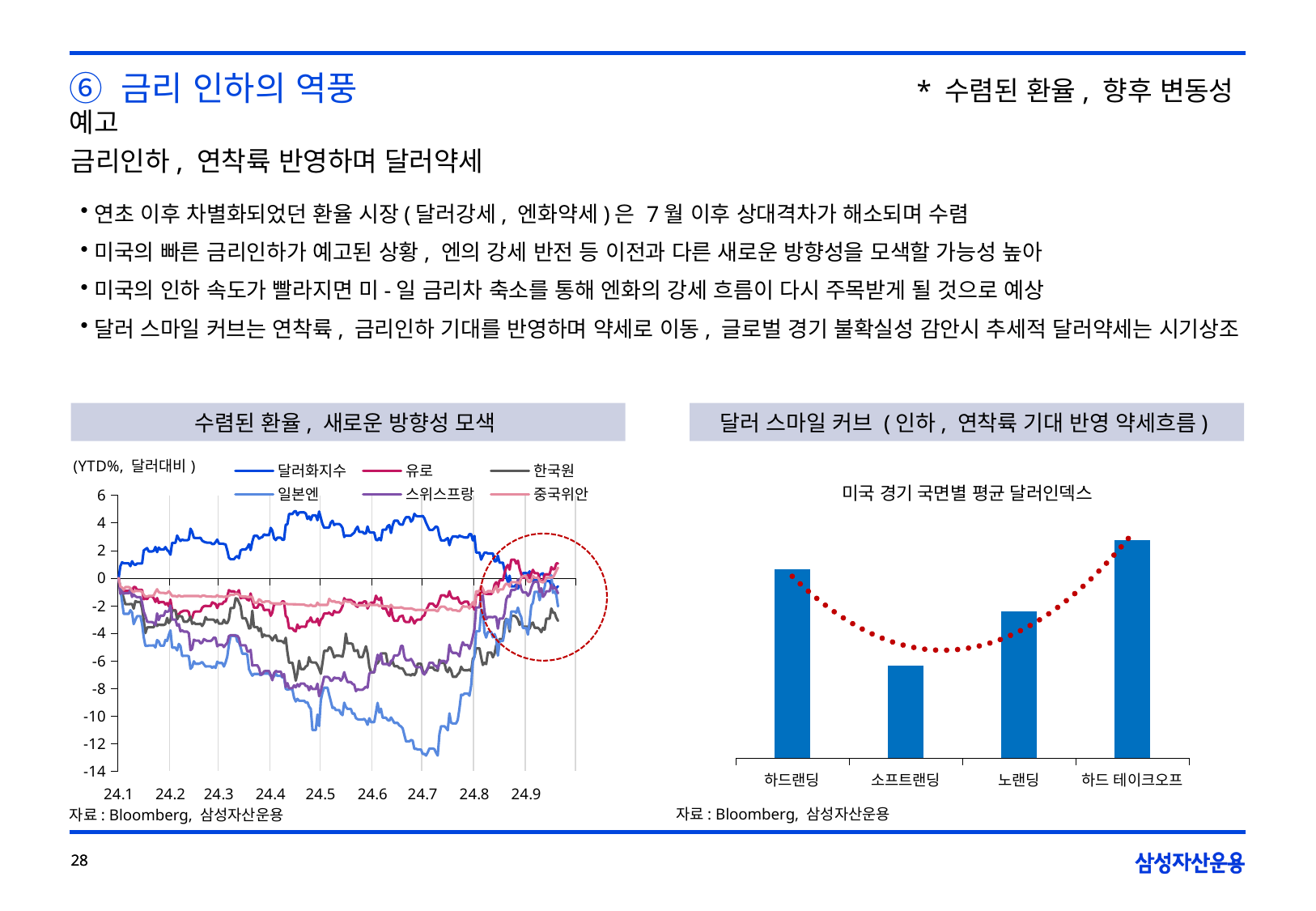
In the right chart '미국 경기 국면별 평균 달러인덱스', which category has the lowest bar? 소프트랜딩 In the left chart '수렴된 환율, 새로운 방향성 모색', is the peak of the 달러화지수 line greater or less than 4? greater In the left chart '수렴된 환율, 새로운 방향성 모색', which series reaches the lowest value during the year? 일본엔 In the left chart '수렴된 환율, 새로운 방향성 모색', is the lowest point of the 일본엔 line greater or less than -10? less In the right chart '미국 경기 국면별 평균 달러인덱스', which bar is taller, 하드랜딩 or 노랜딩? 하드랜딩 What kind of chart is the chart titled '미국 경기 국면별 평균 달러인덱스' on the right? bar chart In the left chart '수렴된 환율, 새로운 방향성 모색', what unit is shown in the top-left corner of the plot area? (YTD%, 달러대비) What kind of chart is the chart titled '수렴된 환율, 새로운 방향성 모색' on the left? line chart In the right chart '미국 경기 국면별 평균 달러인덱스', how many categories are shown on the x axis? 4 In the left chart '수렴된 환율, 새로운 방향성 모색', what is the first label on the x axis? 24.1 In the left chart '수렴된 환율, 새로운 방향성 모색', how many series does the legend list? 6 In the right chart '미국 경기 국면별 평균 달러인덱스', which category has the highest bar? 하드 테이크오프